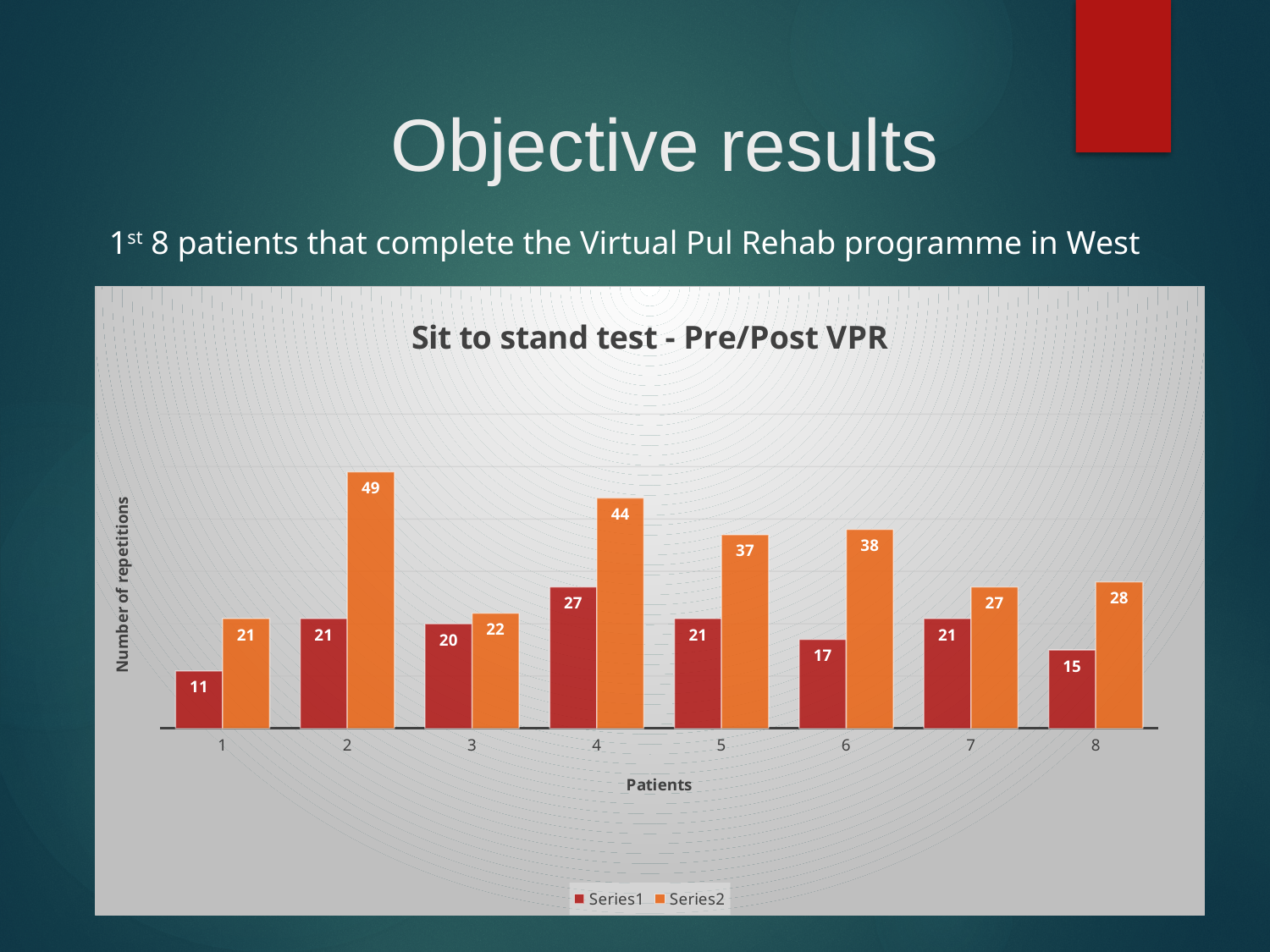
Which patient has the lowest Series1 value? 1 Which is larger for patient 6: the Series1 value or the Series2 value? Series2 What is the title of the chart? Sit to stand test - Pre/Post VPR What is the Series2 value for patient 2? 49 What is the Series1 value for patient 1? 11 Which patient has the highest Series2 value? 2 What kind of chart is shown? bar chart How many series does the legend list? 2 What is the difference between the Series2 and Series1 values for patient 4? 17 What is the Series1 value for patient 4? 27 What is the label of the y axis? Number of repetitions How many patients are shown on the x axis? 8